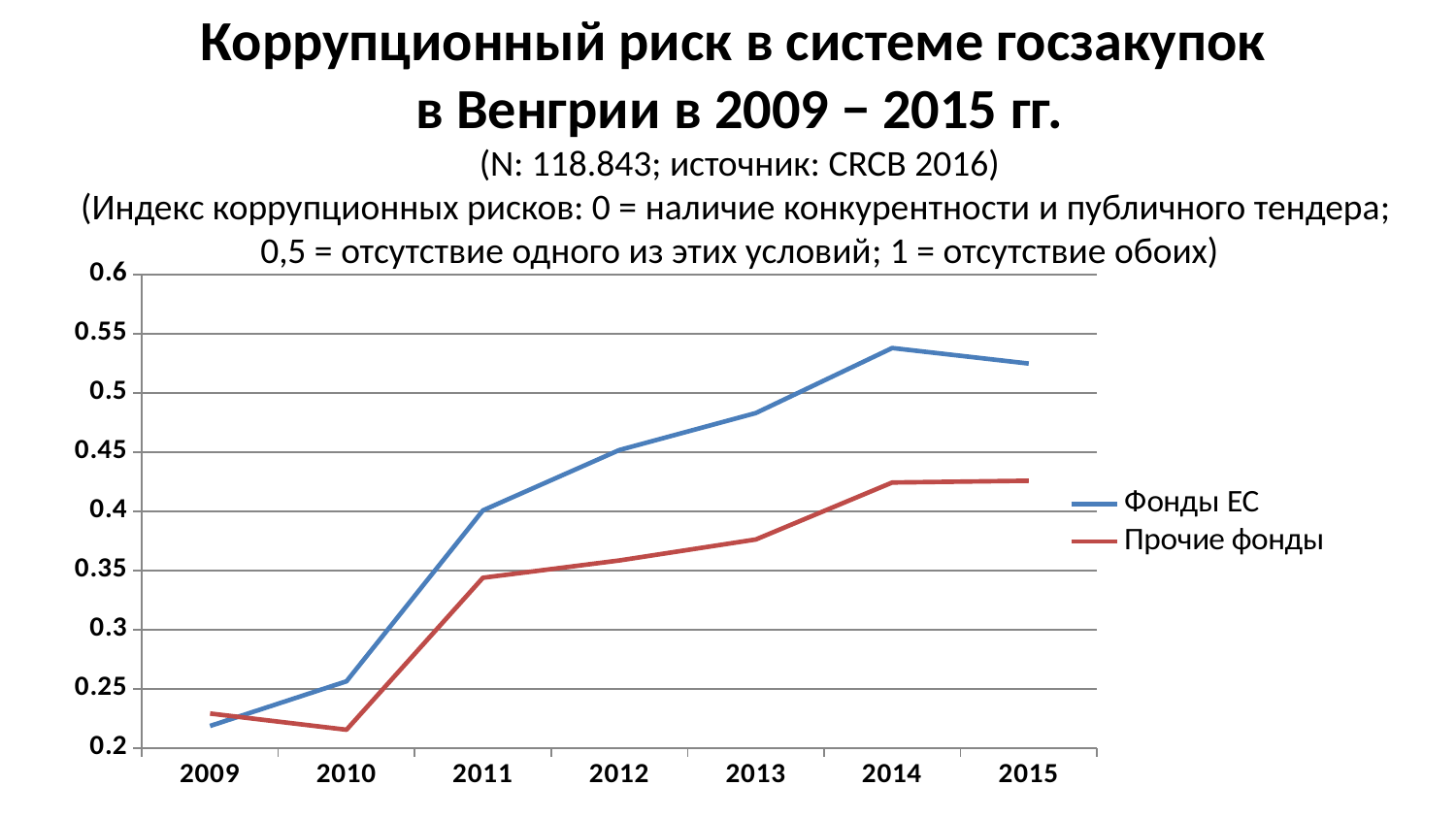
How many series does the legend list? 2 How many years are shown on the x axis? 7 Which series does the blue line represent? Фонды ЕС What kind of chart is shown on the slide? line chart In which year is the Прочие фонды line at its lowest? 2010 Is the value for Фонды ЕС in 2014 greater or less than 0.5? greater In which year does the Фонды ЕС line reach its highest value? 2014 In 2013, which series has the higher value, Фонды ЕС or Прочие фонды? Фонды ЕС In which year is the Фонды ЕС line at its lowest? 2009 Is the value for Фонды ЕС in 2009 greater or less than 0.25? less Does the Прочие фонды line generally rise or fall from 2010 to 2014? rise